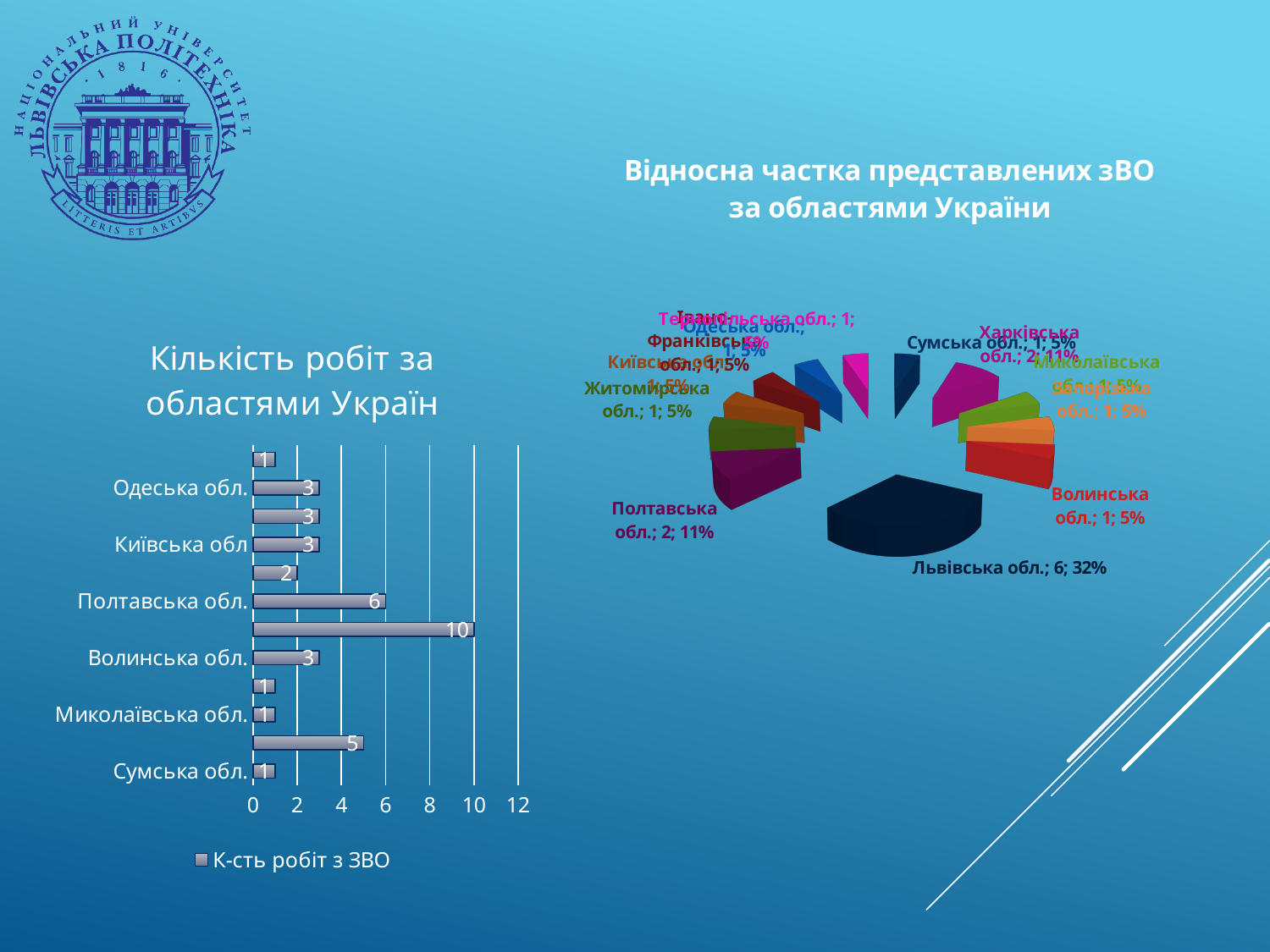
In the bar chart "Кількість робіт за областями Україн", which has the larger value, Полтавська обл. or Волинська обл.? Полтавська обл. In the bar chart "Кількість робіт за областями Україн", what is the value for Полтавська обл.? 6 In the bar chart "Кількість робіт за областями Україн", what is the difference between the values for Полтавська обл. and Сумська обл.? 5 How many series does the legend of the bar chart "Кількість робіт за областями Україн" list? 1 In the bar chart "Кількість робіт за областями Україн", what is the value for Одеська обл.? 3 What kind of chart is the left chart titled "Кількість робіт за областями Україн"? bar chart In the bar chart "Кількість робіт за областями Україн", what is the largest value shown on any bar? 10 How many bars are plotted in the bar chart "Кількість робіт за областями Україн"? 12 In the bar chart "Кількість робіт за областями Україн", what is the value for Миколаївська обл.? 1 What kind of chart is the right chart titled "Відносна частка представлених зВО за областями України"? pie chart In the pie chart "Відносна частка представлених зВО за областями України", which region has the largest slice? Львівська обл. In the pie chart "Відносна частка представлених зВО за областями України", what share does Львівська обл. have? 32%